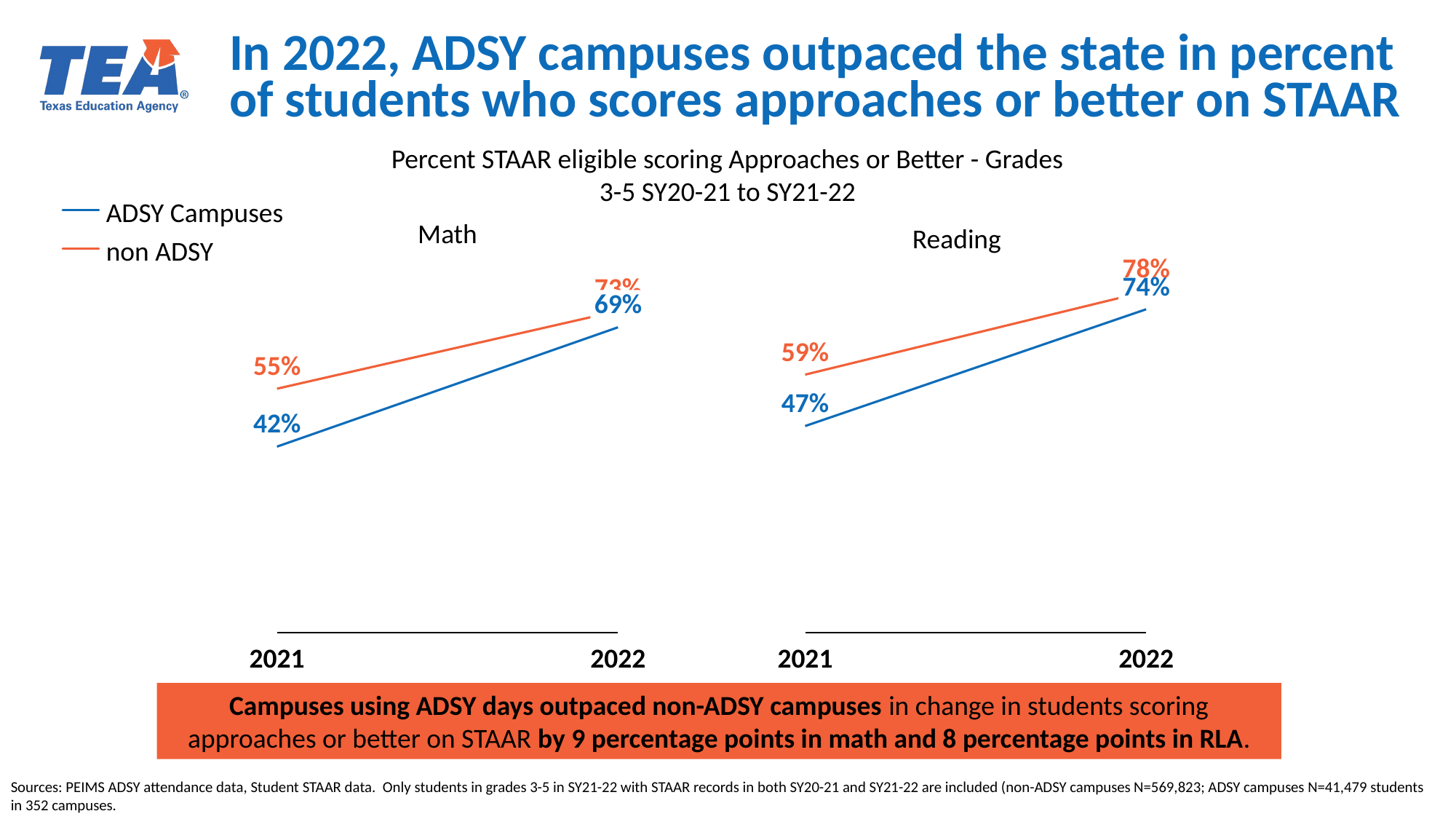
In the Math panel, what is the value for ADSY Campuses in 2021? 42% In the Math panel, what is the difference between the non ADSY and ADSY Campuses values in 2021? 13 percentage points In the Reading panel, what is the value for ADSY Campuses in 2022? 74% In the Math panel, do the ADSY Campuses values rise or fall from 2021 to 2022? Rise In the Reading panel, what is the value for non ADSY in 2022? 78% In the Reading panel, what is the value for ADSY Campuses in 2021? 47% How many series does the legend list? 2 In the Math panel, what is the value for ADSY Campuses in 2022? 69% In the Math panel, what is the value for non ADSY in 2021? 55% What kind of chart is shown on the slide? Line chart In the Reading panel, by how many percentage points did the ADSY Campuses value increase from 2021 to 2022? 27 percentage points In the Reading panel, which series has the higher value in 2022, ADSY Campuses or non ADSY? non ADSY